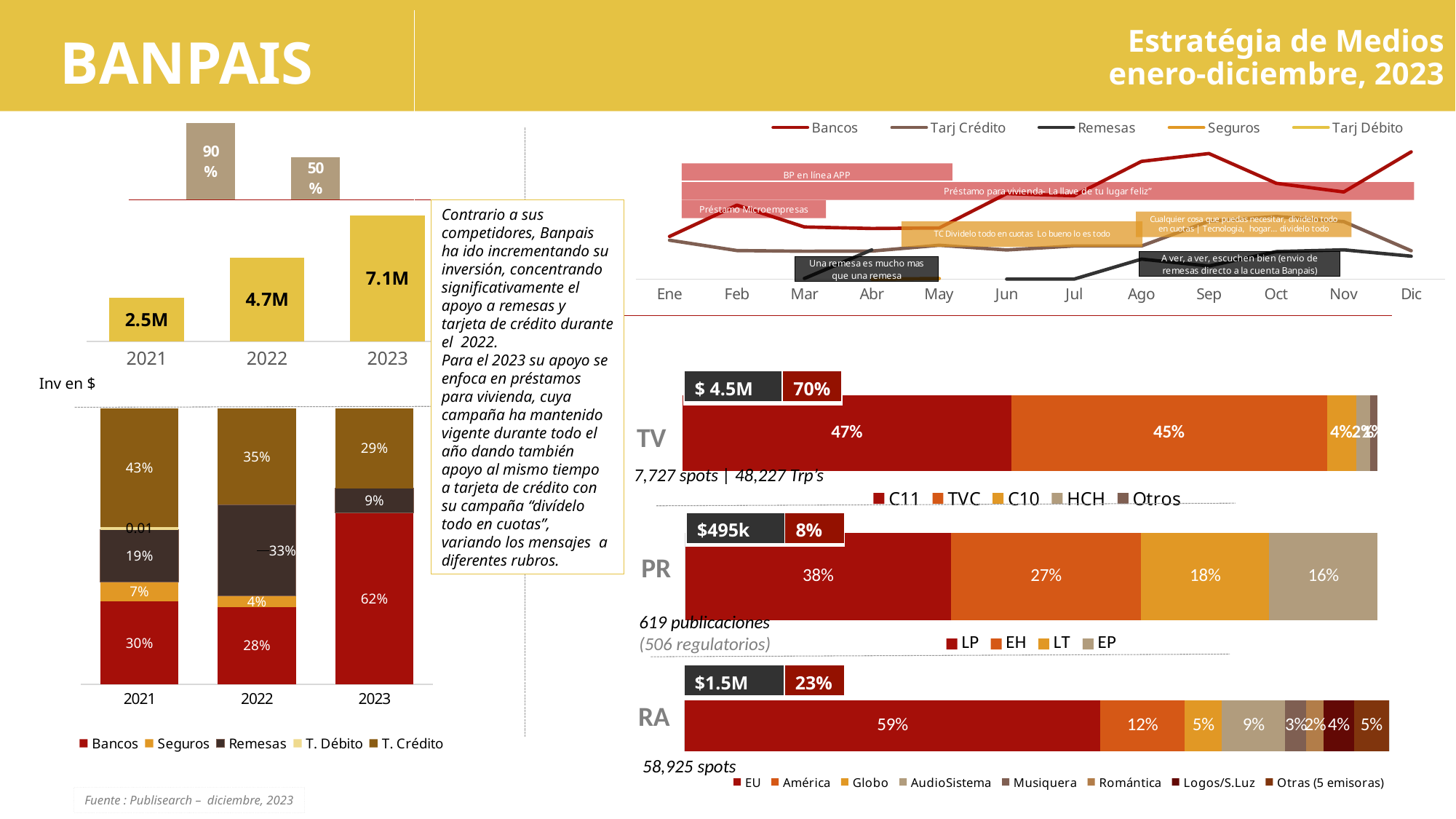
In the RA bar on the right, which station has the largest share? EU In the stacked bar chart at the bottom left, how many series does the legend list? 5 In the stacked bar chart at the bottom left, which is larger in 2022: Remesas or Bancos? Remesas In the 'Inv en $' bar chart on the left, what is the investment value shown for 2021? 2.5M In the PR bar on the right, what is the difference between the LP share and the EP share? 22% In the stacked bar chart at the bottom left, what percentage does Bancos represent in 2023? 62% In the TV bar on the right, what share does C11 have? 47% In the 'Inv en $' bar chart on the left, what is the investment value shown for 2023? 7.1M In the 'Inv en $' bar chart on the left, do the investment values rise or fall from 2021 to 2023? rise In the 'Inv en $' bar chart on the left, which year has the highest investment? 2023 In the stacked bar chart at the bottom left, what percentage does T. Crédito represent in 2021? 43% In the line chart at the top right, how many months are shown on the x axis? 12